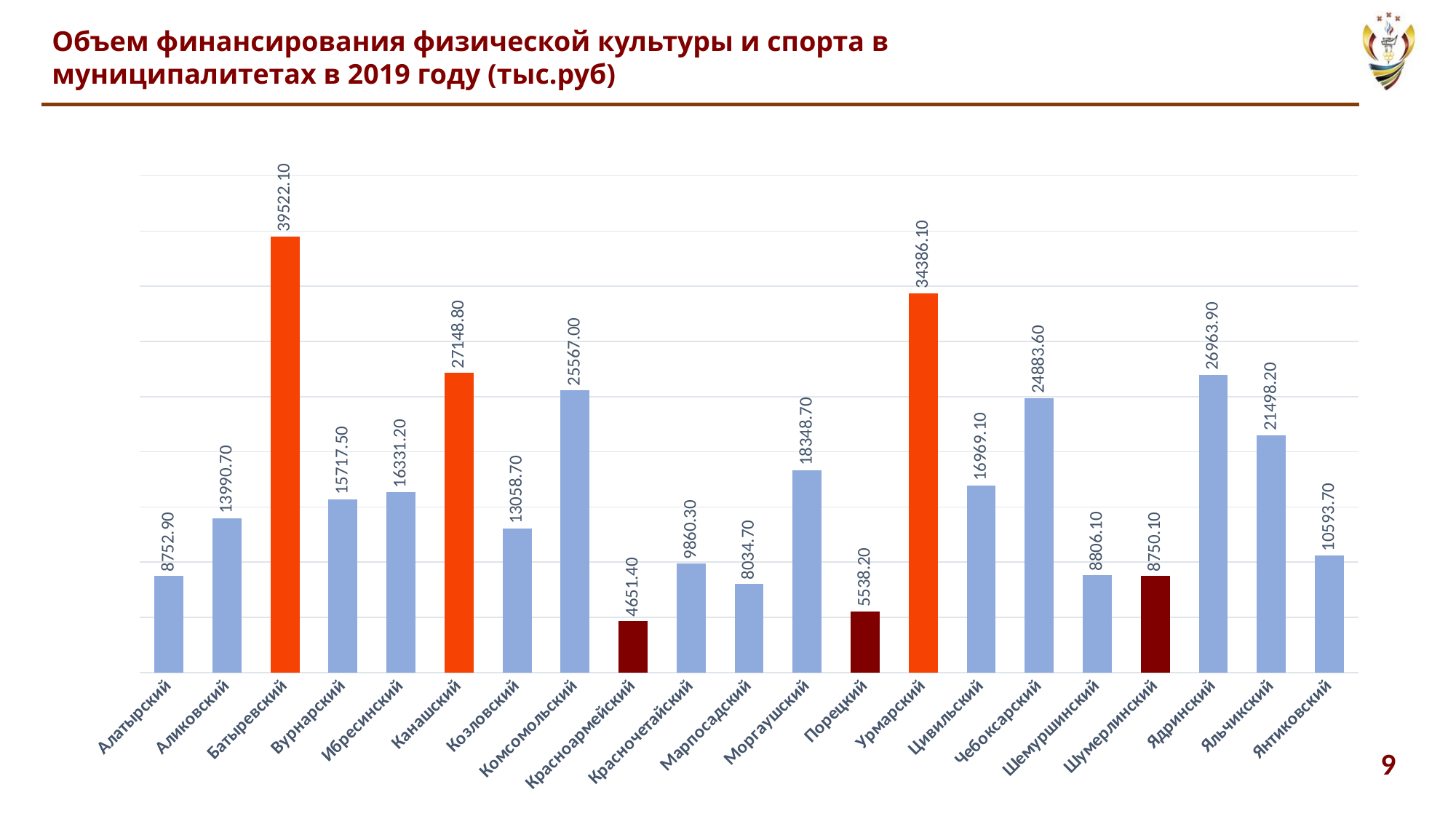
What is the value for Батыревский? 39522.10 What kind of chart is shown on the slide? bar chart What is the value for Ядринский? 26963.90 How many municipalities are shown in the chart? 21 What is the title of the chart? Объем финансирования физической культуры и спорта в муниципалитетах в 2019 году (тыс.руб) What is the value for Красноармейский? 4651.40 Which municipality has the highest value? Батыревский What is the difference between the values for Канашский and Комсомольский? 1581.80 What is the value for Урмарский? 34386.10 Which municipality has the lowest value? Красноармейский What is the difference between the values for Батыревский and Урмарский? 5136.00 Which is larger, the value for Чебоксарский or the value for Яльчикский? Чебоксарский